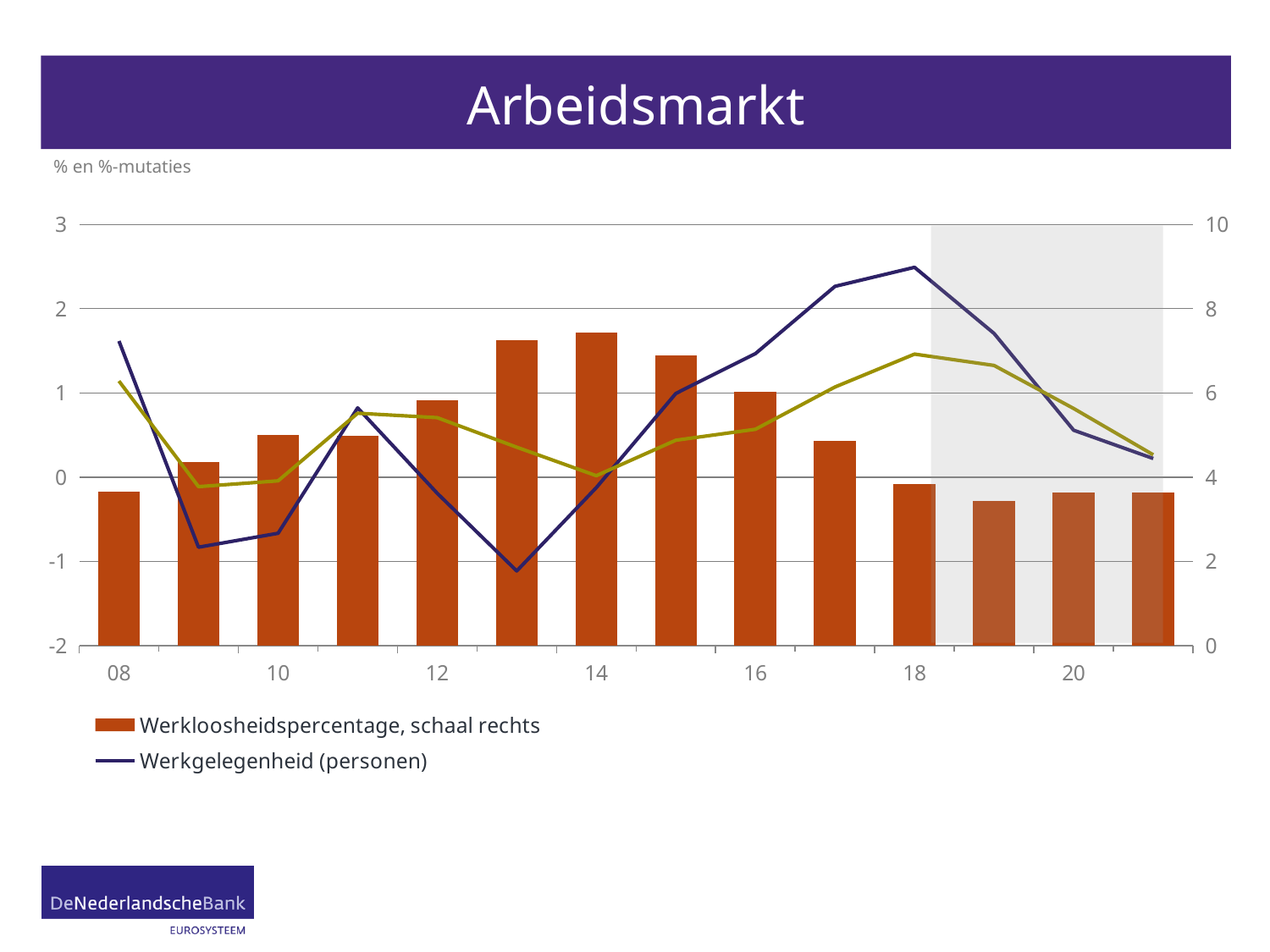
Does the Werkgelegenheid (personen) line rise or fall between 15 and 18? rise In which year does the Werkgelegenheid (personen) line reach its lowest value? 13 How many bars (years) are plotted for Werkloosheidspercentage? 14 What is the title of the chart on the slide? Arbeidsmarkt What kind of chart is shown on the slide? Combined bar and line chart Is the Werkloosheidspercentage bar for 08 greater or less than 4 on the right scale? less Which series is plotted on the right-hand scale according to the legend? Werkloosheidspercentage Is the Werkloosheidspercentage bar for 14 greater or less than 6 on the right scale? greater Which year has the larger Werkloosheidspercentage bar, 13 or 17? 13 In which year does the Werkgelegenheid (personen) line reach its highest value? 18 Is the Werkgelegenheid (personen) value for 18 greater or less than 2? greater How many series does the chart legend list? 2